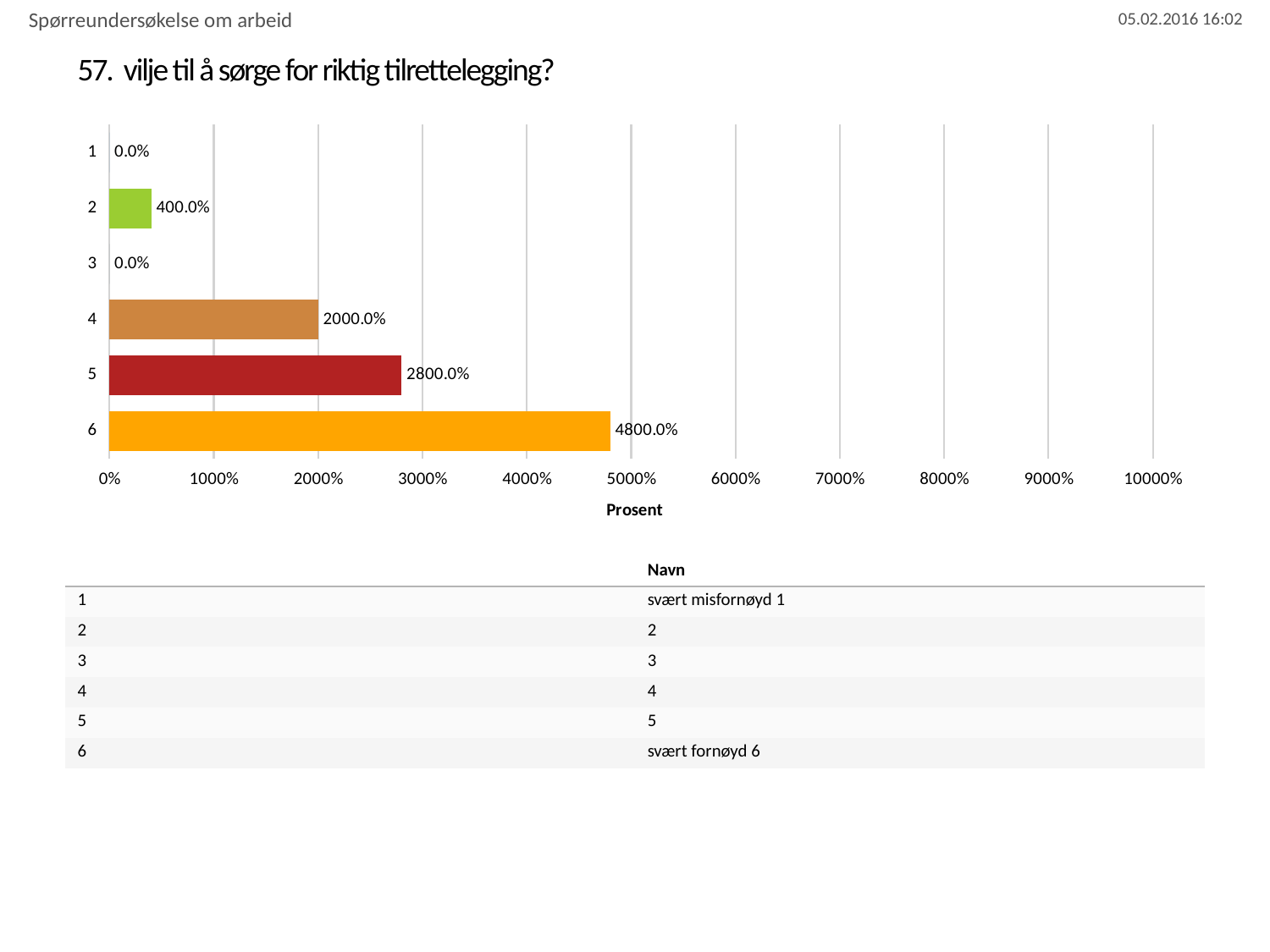
What is the value for category 3? 0.0% Is the value for category 6 greater or less than 4000%? greater What kind of chart is shown on the slide? bar chart What is the difference between the values for category 6 and category 5? 2000.0% What is the value for category 4? 2000.0% What is the label of the horizontal axis? Prosent What is the value for category 2? 400.0% What is the value for category 6? 4800.0% Which has a larger value, category 4 or category 5? 5 How many categories are shown on the chart? 6 What is the difference between the values for category 5 and category 4? 800.0% Which category has the highest value? 6